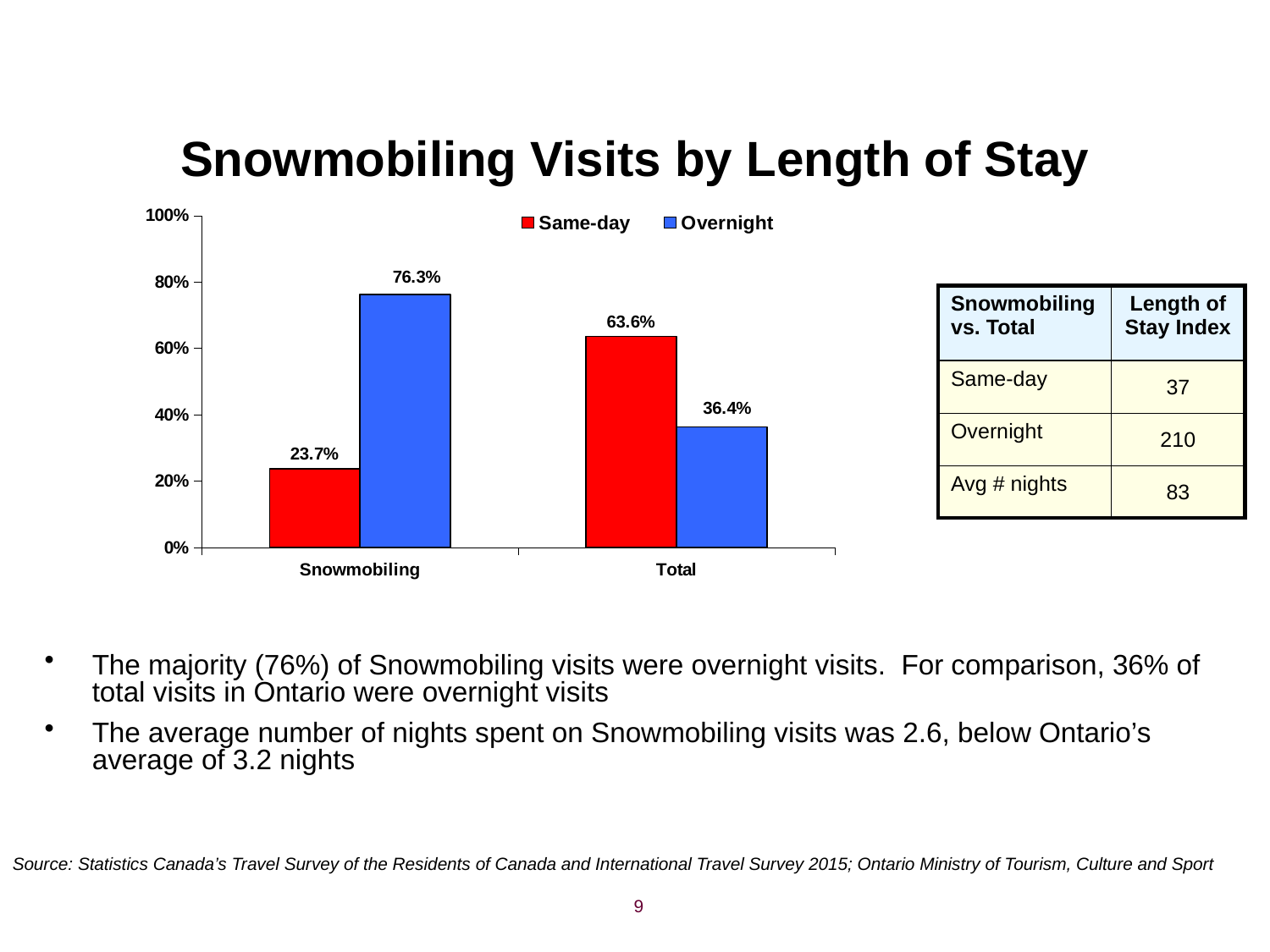
What is the Same-day value for Total? 63.6% How many categories are shown on the x axis? 2 What is the Overnight value for Snowmobiling? 76.3% Which category has the lowest Same-day value? Snowmobiling Which is larger for Snowmobiling: the Same-day value or the Overnight value? Overnight What is the difference between the Overnight values for Snowmobiling and Total? 39.9% What kind of chart is shown on the slide? Bar chart What is the Same-day value for Snowmobiling? 23.7% What is the title of the chart? Snowmobiling Visits by Length of Stay Which category has the highest Overnight value? Snowmobiling How many series does the legend list? 2 What is the Overnight value for Total? 36.4%